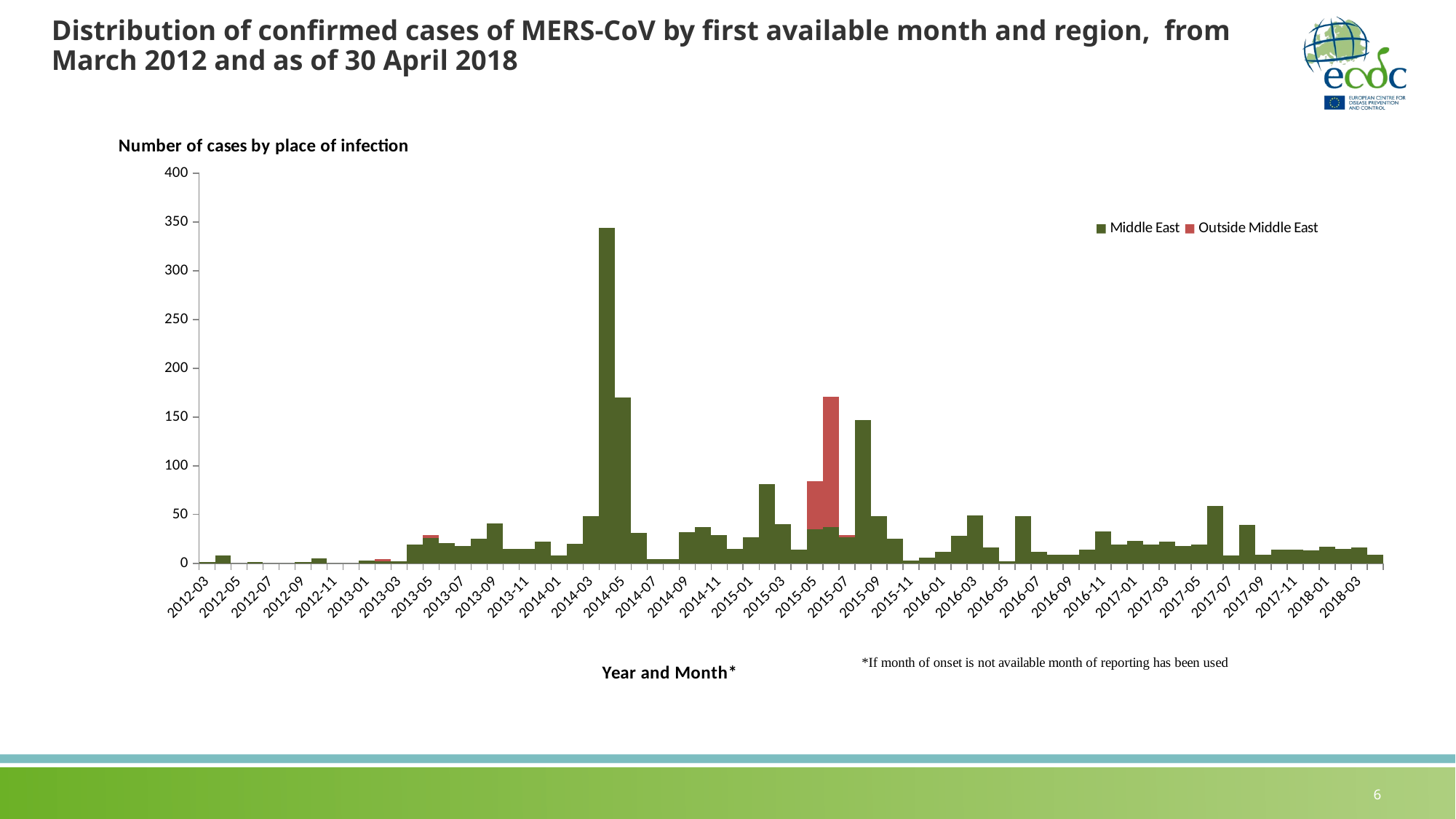
Is the value for 2018-03 greater or less than 50? less Which is larger, the value for 2014-05 or the value for 2012-05? 2014-05 What kind of chart is shown on the slide? bar chart Is the value for 2016-05 greater or less than 50? less Is the value for 2014-05 greater or less than 150? greater How many series does the legend list? 2 What are the two series named in the legend? Middle East and Outside Middle East Which series is shown in red? Outside Middle East What is the title of the x axis? Year and Month*